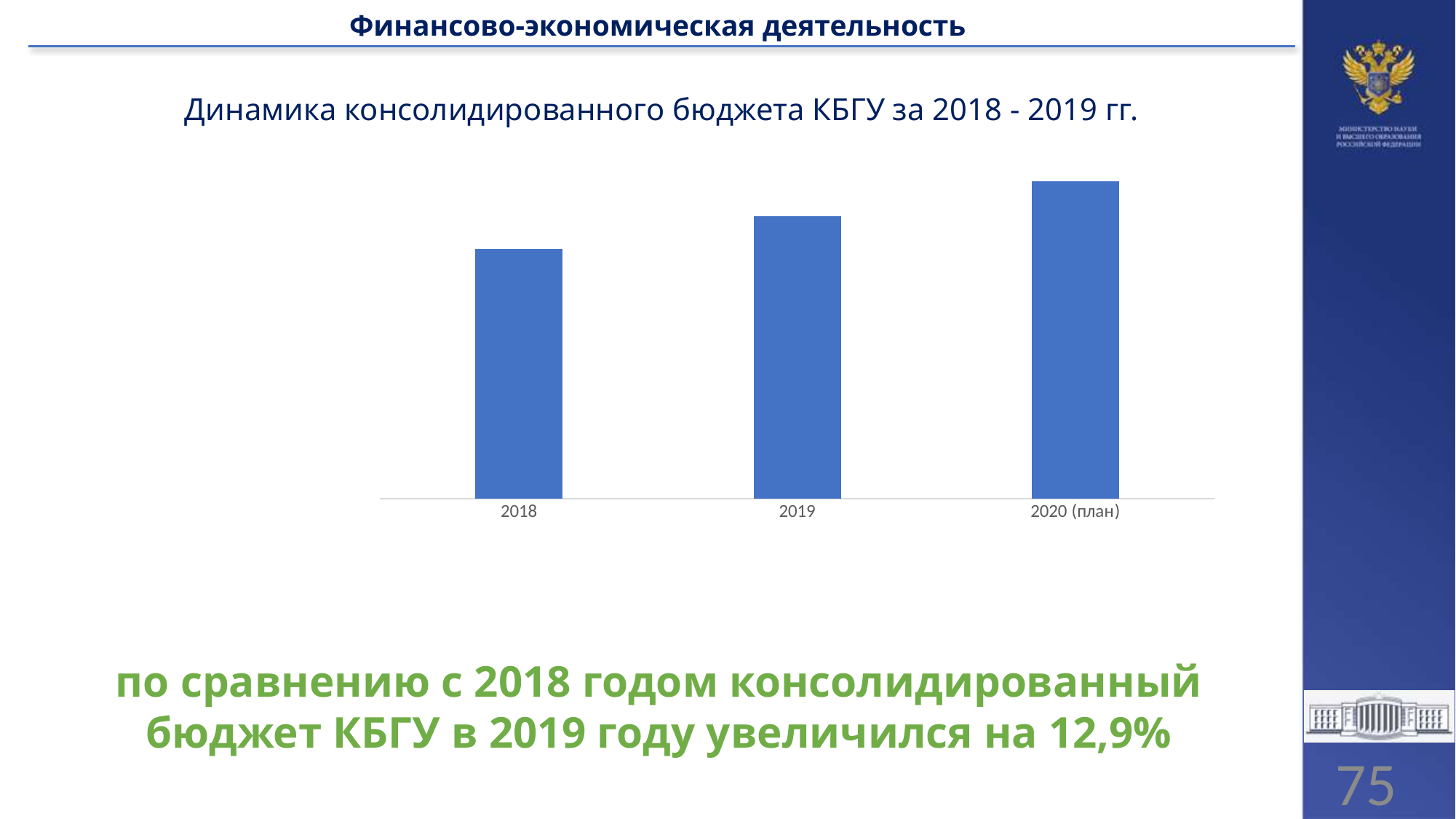
Which is larger, the value for 2018 or the value for 2019? 2019 What kind of chart is shown on the slide? bar chart Do the values rise or fall from 2018 to 2020 (план)? rise How many bars (categories) does the chart show? 3 Which category has the highest bar? 2020 (план) Which category has the lowest bar? 2018 What is the title of the chart? Динамика консолидированного бюджета КБГУ за 2018 - 2019 гг. What are the category labels on the x axis of the chart? 2018, 2019, 2020 (план) Which is larger, the value for 2019 or the value for 2020 (план)? 2020 (план)